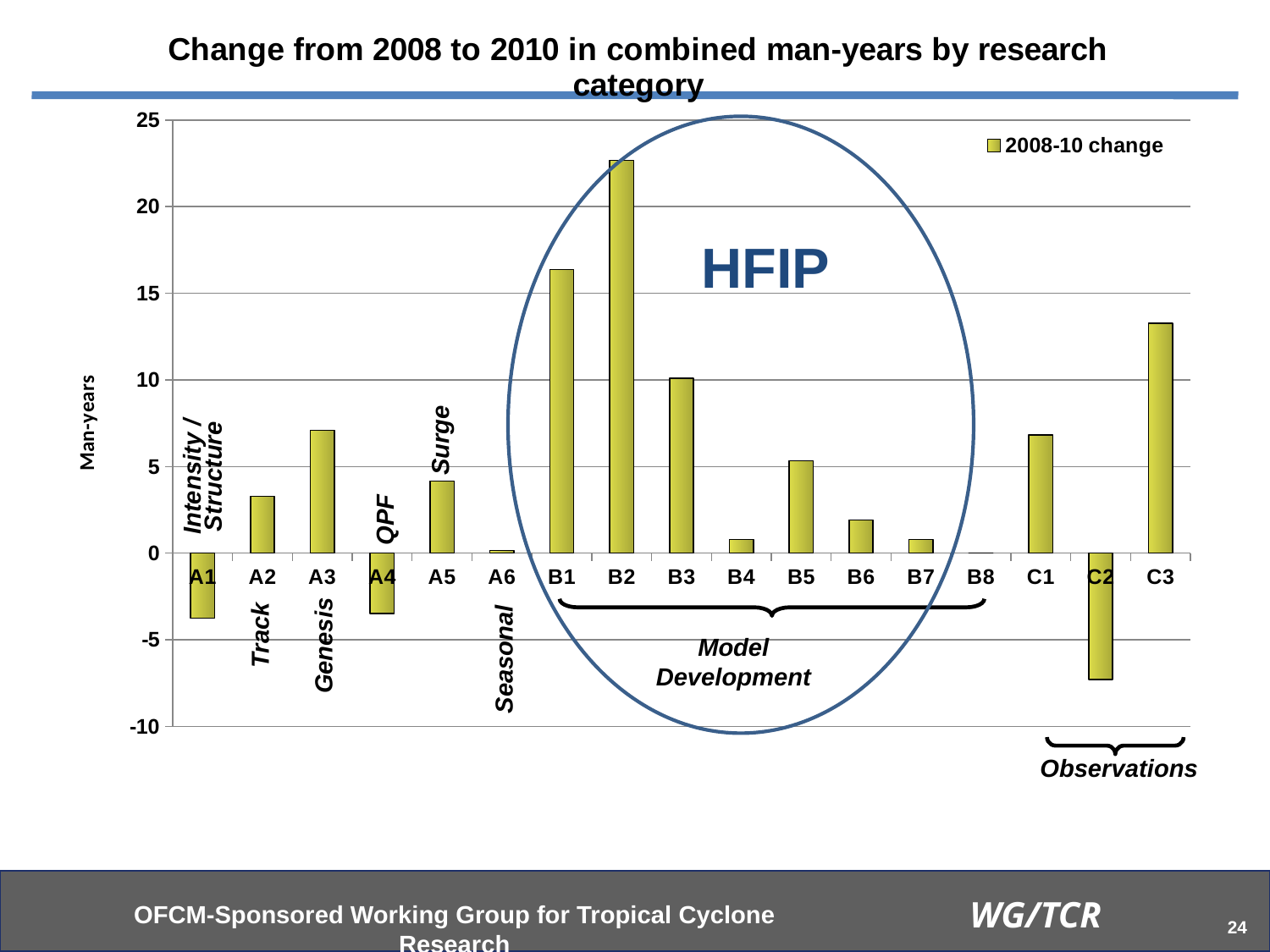
Is the value for B1 greater or less than 15? greater Which has the larger 2008-10 change, B1 or B3? B1 Which has the larger 2008-10 change, C1 or C3? C3 Which category has the highest 2008-10 change in man-years? B2 What kind of chart is shown on the slide? bar chart Which category has the lowest 2008-10 change in man-years? C2 What is the label of the y axis? Man-years How many series does the legend list? 1 How many research categories are plotted along the x axis? 17 Is the value for B2 greater or less than 20? greater Is the value for C2 greater or less than -5? less